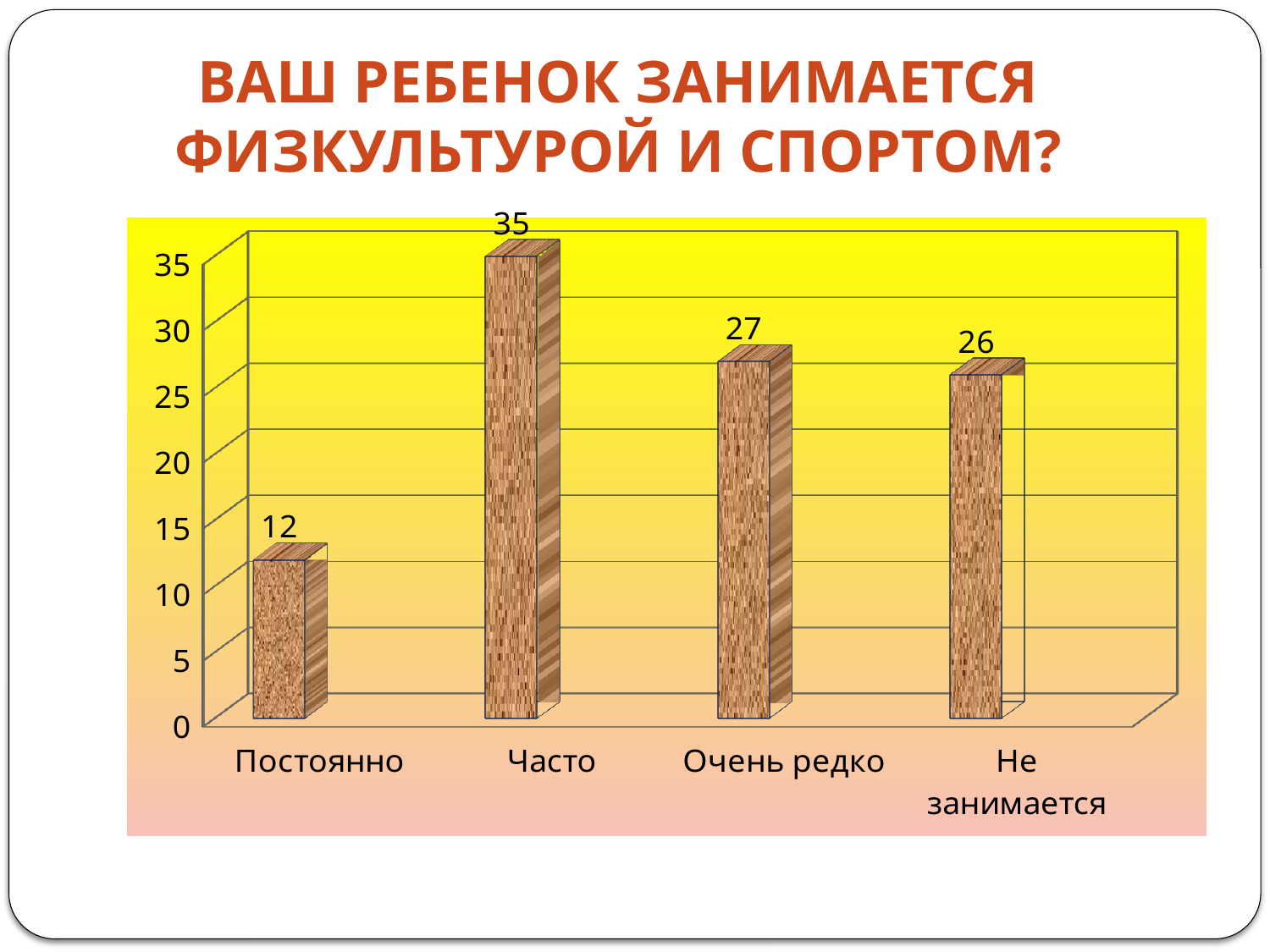
Which category has the lowest value? Постоянно What is the value for Часто? 35 What is the difference between the values for Очень редко and Не занимается? 1 What is the value for Постоянно? 12 What kind of chart is shown on the slide? bar chart Which category has the highest value? Часто How many categories are shown on the chart? 4 What is the value for Не занимается? 26 What is the value for Очень редко? 27 What is the title of the slide? ВАШ РЕБЕНОК ЗАНИМАЕТСЯ ФИЗКУЛЬТУРОЙ И СПОРТОМ? What is the difference between the values for Часто and Постоянно? 23 Which is larger, the value for Очень редко or the value for Постоянно? Очень редко